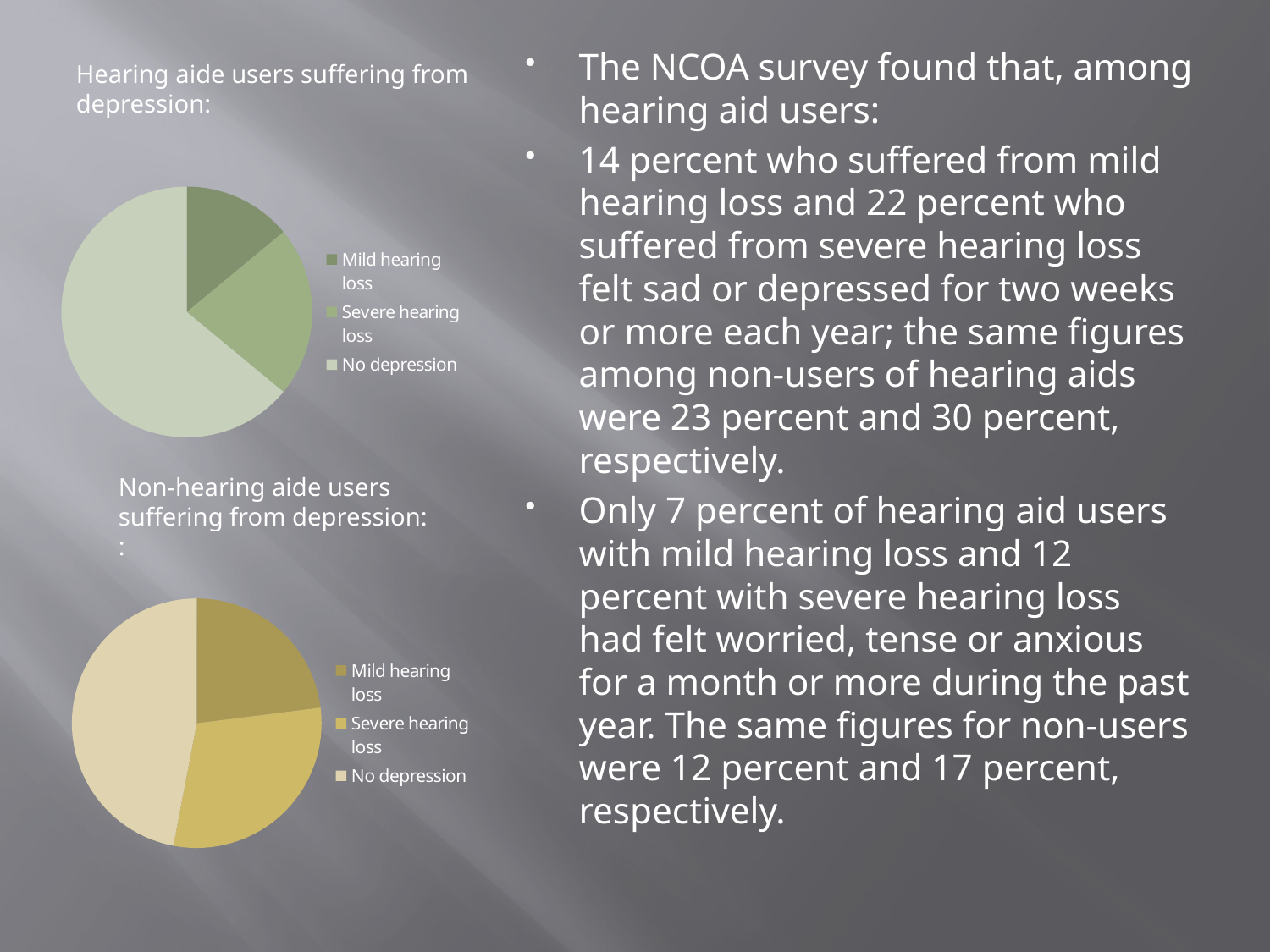
In the 'Hearing aide users suffering from depression' chart, how many slices does the pie have? 3 How many pie charts are shown on the slide? 2 What kind of chart is the 'Non-hearing aide users suffering from depression' chart? Pie chart In the 'Non-hearing aide users suffering from depression' chart, how many categories does the legend list? 3 In the 'Non-hearing aide users suffering from depression' chart, which slice is larger: No depression or Mild hearing loss? No depression In the 'Hearing aide users suffering from depression' chart, which category has the largest slice? No depression What are the three legend entries in the 'Non-hearing aide users suffering from depression' chart? Mild hearing loss, Severe hearing loss, No depression In the 'Hearing aide users suffering from depression' chart, which category has the smallest slice? Mild hearing loss In the 'Hearing aide users suffering from depression' chart, which slice is larger: No depression or Severe hearing loss? No depression What kind of chart is the 'Hearing aide users suffering from depression' chart? Pie chart In the 'Non-hearing aide users suffering from depression' chart, which category has the largest slice? No depression In the 'Hearing aide users suffering from depression' chart, which slice is larger: Severe hearing loss or Mild hearing loss? Severe hearing loss